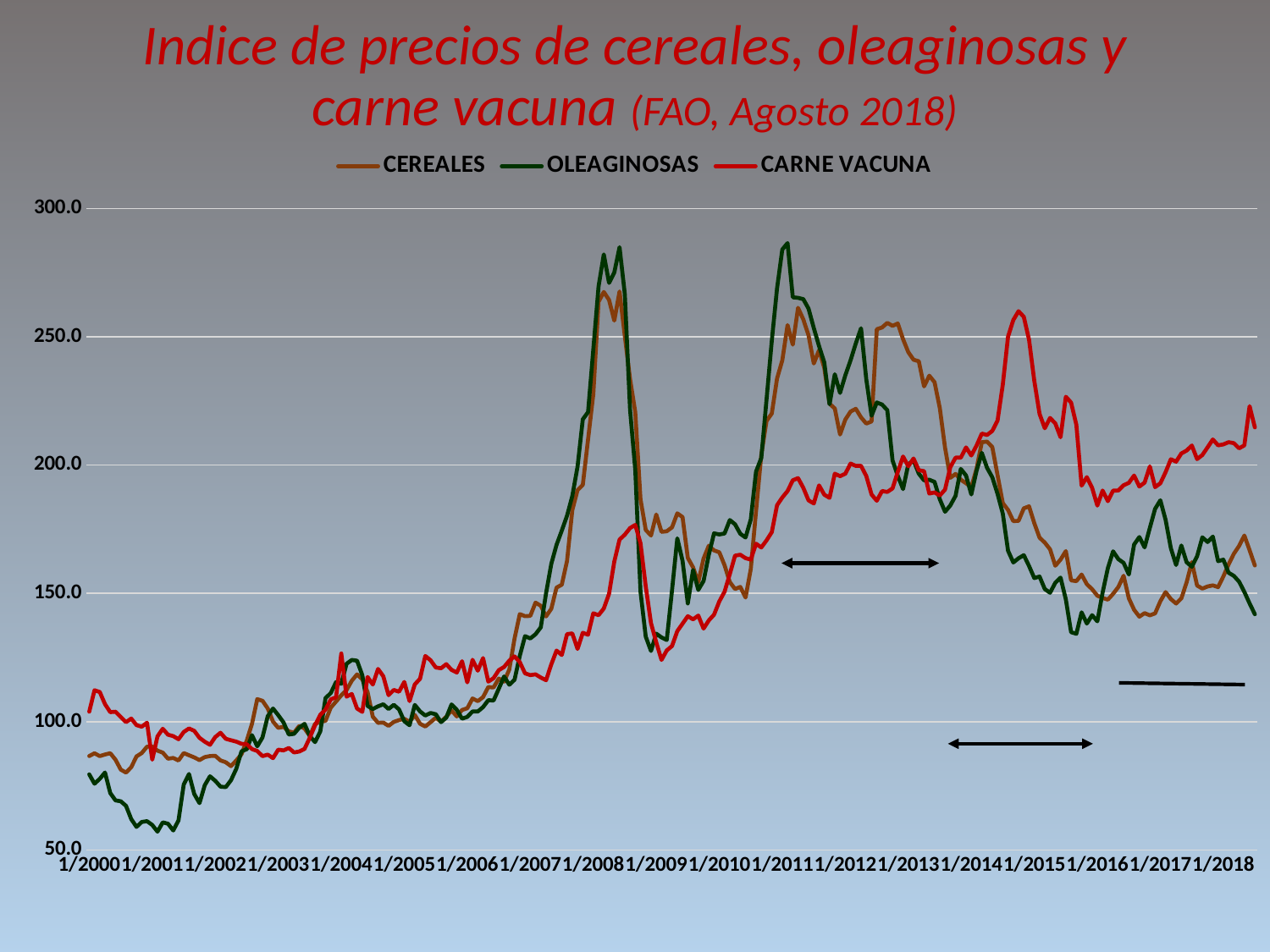
What colour is the CARNE VACUNA line? red What is the title of the chart? Indice de precios de cereales, oleaginosas y carne vacuna (FAO, Agosto 2018) What kind of chart is shown on the slide? line chart Which series has the lowest value at 1/2001? OLEAGINOSAS Is the value for CARNE VACUNA at 1/2015 greater or less than 200? greater Is the value for CEREALES at 1/2000 greater or less than 100? less Which series reaches the highest value anywhere on the chart? OLEAGINOSAS Is the peak value of OLEAGINOSAS around 1/2008 greater or less than 250? greater At 1/2018, which is larger: CARNE VACUNA or OLEAGINOSAS? CARNE VACUNA How many series does the legend list? 3 Does the CARNE VACUNA line rise or fall between 1/2016 and 1/2018? rise